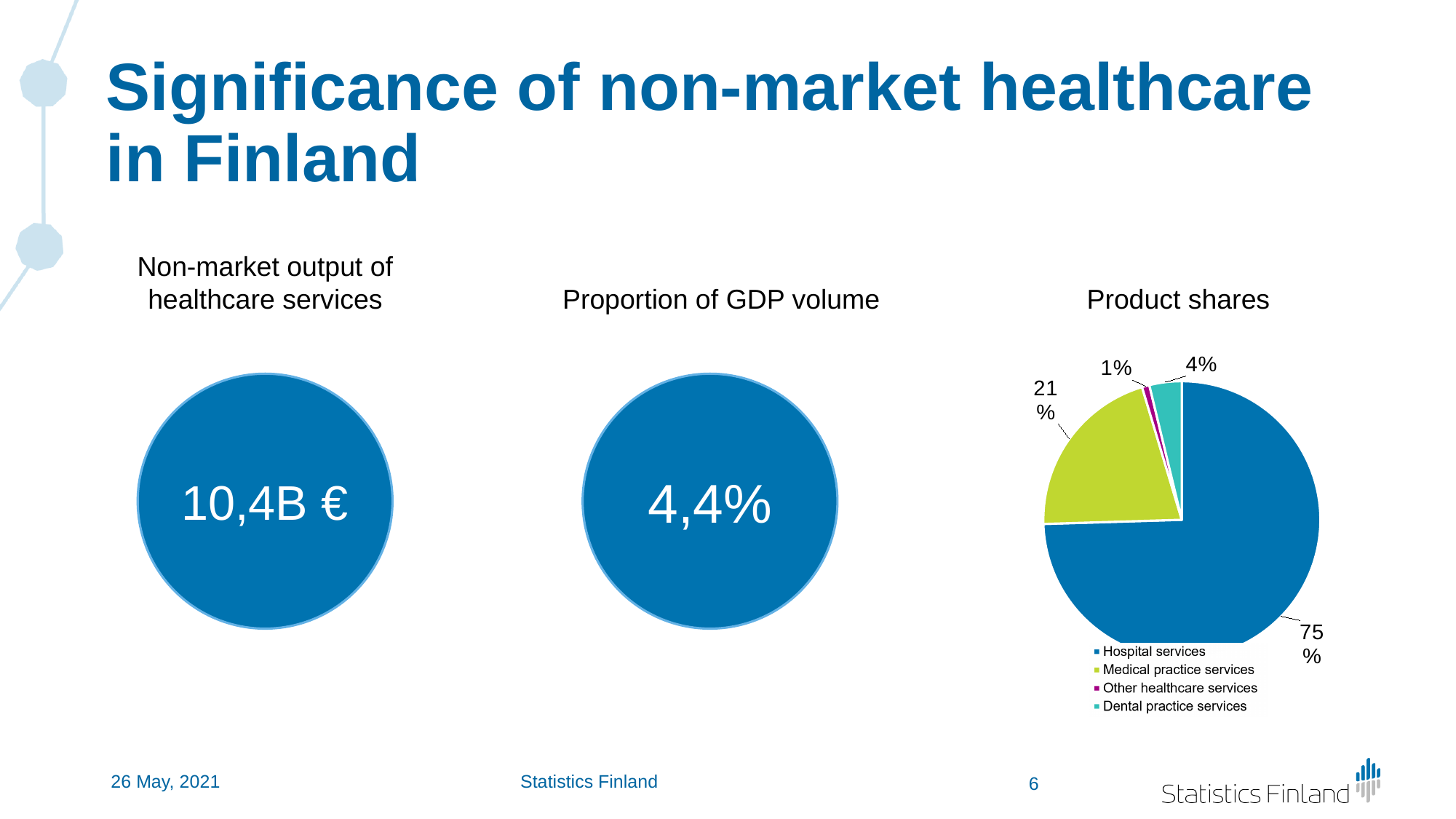
In the Product shares chart, what is the difference in percentage points between Hospital services and Medical practice services? 54 In the Product shares chart, what share do Dental practice services have? 4% What kind of chart is the Product shares chart? Pie chart In the Product shares chart, what share do Hospital services have? 75% In the Product shares chart, which category has the largest share? Hospital services In the Product shares chart, which category has the smallest share? Other healthcare services In the Product shares chart, what colour is the Medical practice services slice? Green In the Product shares chart, what share do Other healthcare services have? 1% In the Product shares chart, which is larger: Dental practice services or Other healthcare services? Dental practice services What is the title of the pie chart on the slide? Product shares How many categories does the Product shares chart show? 4 In the Product shares chart, what share do Medical practice services have? 21%